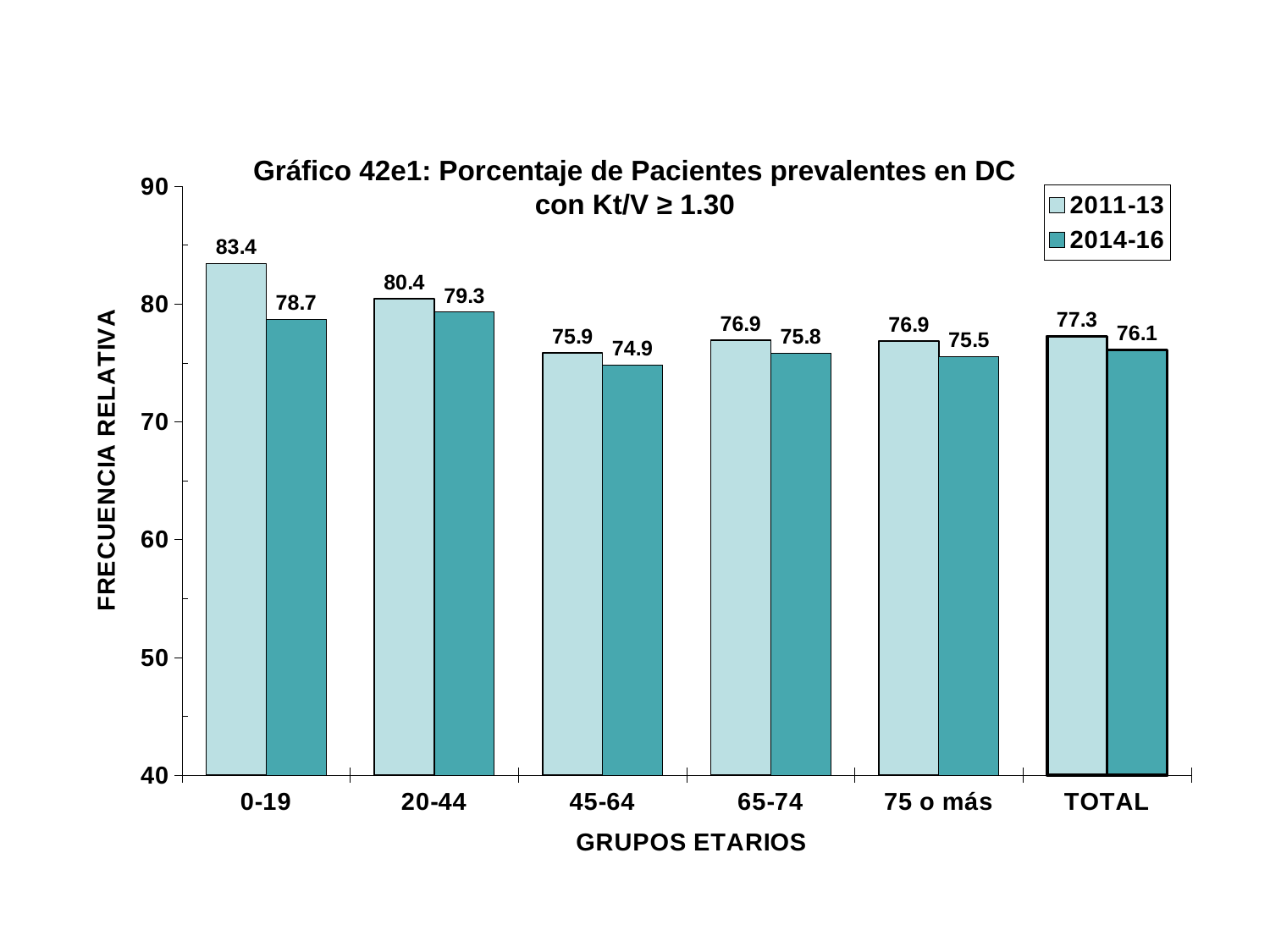
What is the TOTAL value for the 2014-16 series? 76.1 Is the 2014-16 value for the 75 o más age group greater or less than 80? less What is the value for the 45-64 age group in the 2014-16 series? 74.9 What is the value for the 0-19 age group in the 2011-13 series? 83.4 Which age group has the lowest value in the 2014-16 series? 45-64 What kind of chart is shown on the slide? bar chart Which age group has the highest value in the 2011-13 series? 0-19 How many categories are shown on the x axis? 6 How many series does the legend list? 2 Which is larger for the 20-44 age group: the 2011-13 value or the 2014-16 value? 2011-13 What is the difference between the 2011-13 and 2014-16 values for the 0-19 age group? 4.7 What is the label of the y axis? FRECUENCIA RELATIVA